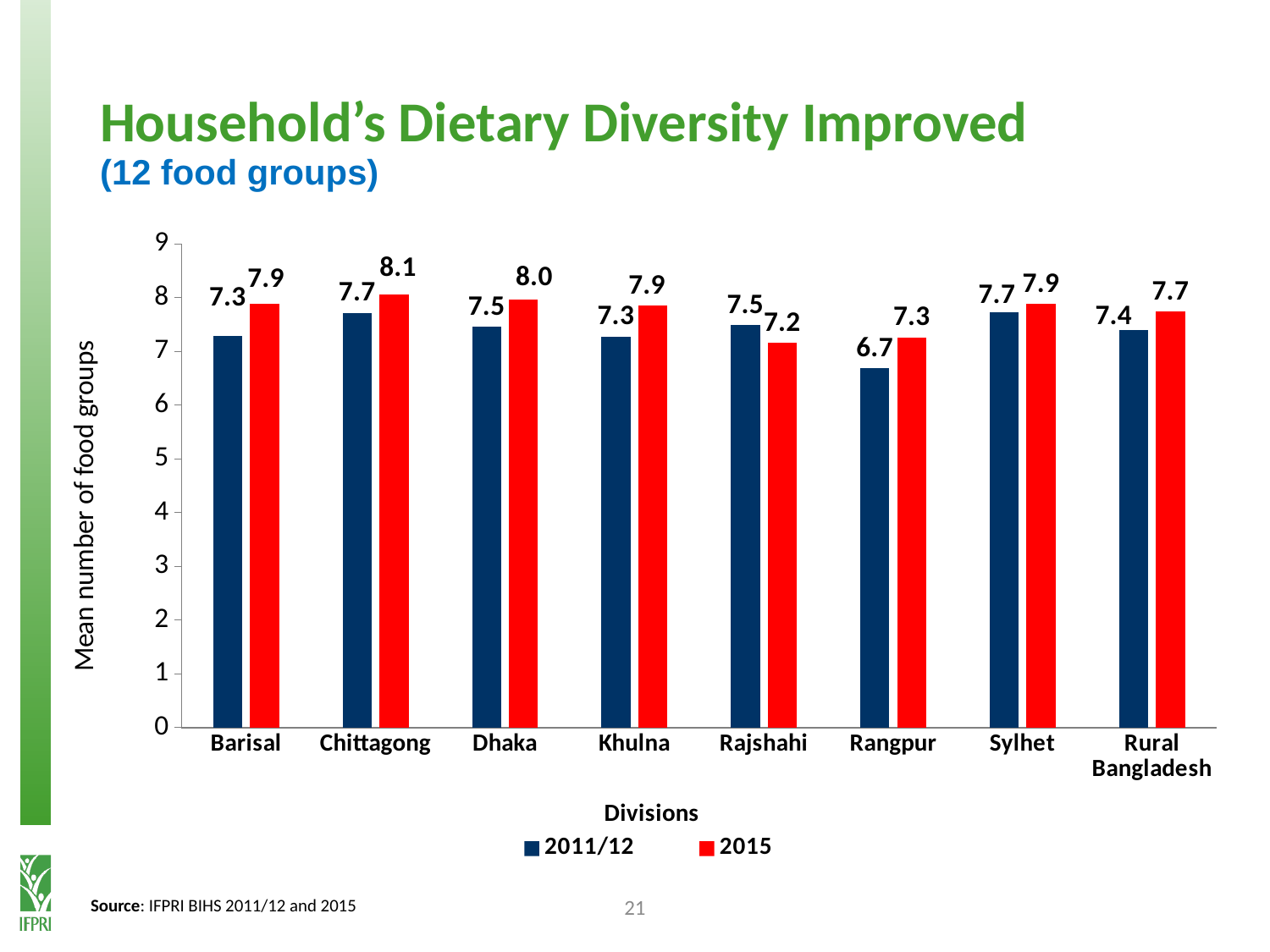
What is the label of the y axis? Mean number of food groups Which division has the highest 2015 value? Chittagong What is the difference between the 2015 and 2011/12 values for Barisal? 0.6 How many series does the legend list? 2 What is the 2015 value for Rural Bangladesh? 7.7 What kind of chart is shown on the slide? bar chart For Rajshahi, which is larger: the 2011/12 value or the 2015 value? 2011/12 How many categories are shown on the x axis? 8 Which category has the lowest 2011/12 value? Rangpur What is the 2011/12 value for Rangpur? 6.7 What is the 2015 value for Chittagong? 8.1 Is the 2011/12 value for Rangpur greater or less than 7? less